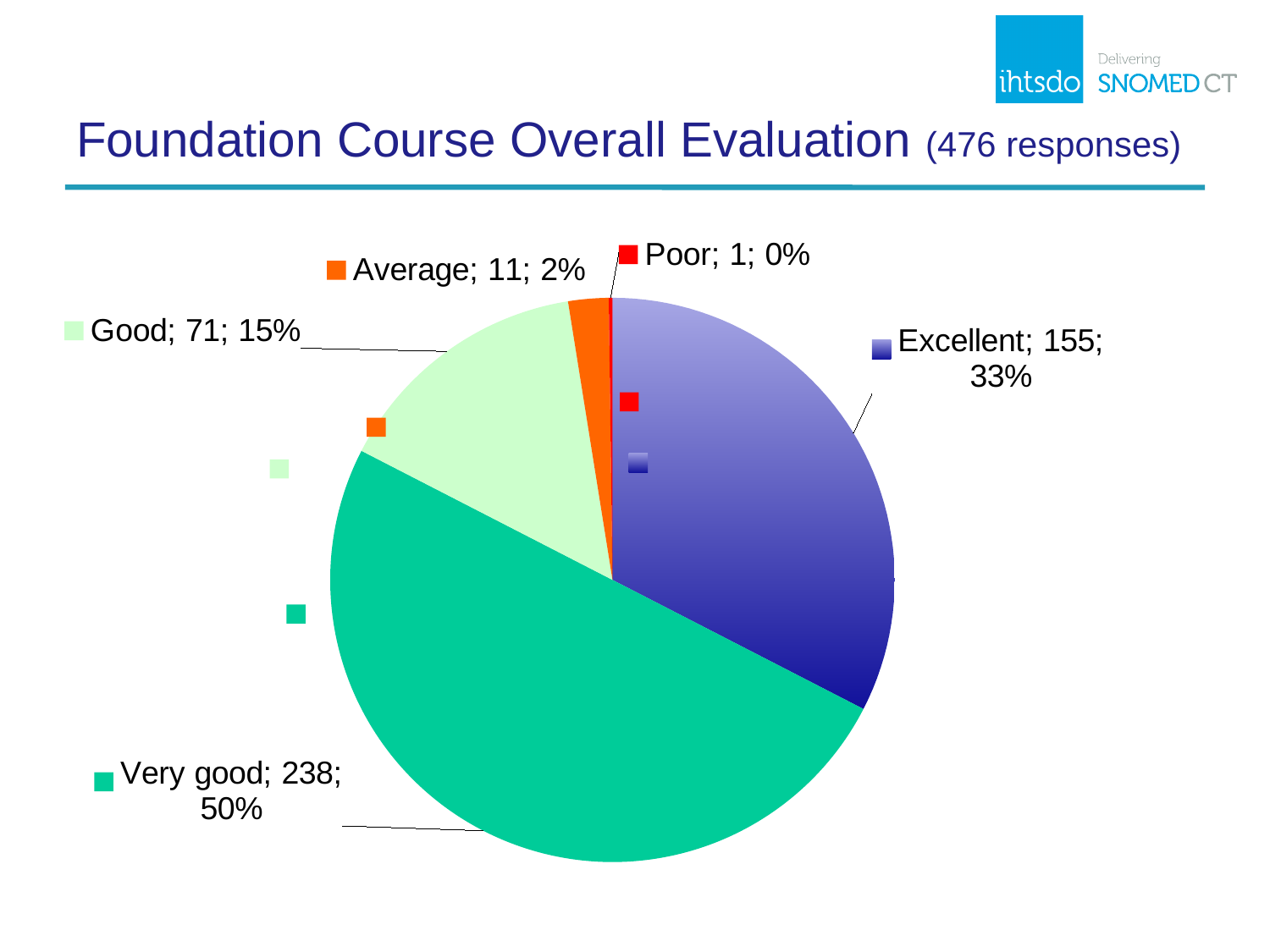
What is the difference between the number of Very good and Excellent responses? 83 What kind of chart is shown on the slide? pie chart How many responses were rated Good? 71 How many responses were rated Excellent? 155 Which rating category has the smallest slice of the pie? Poor What percentage of responses were rated Very good? 50% What percentage of responses were rated Average? 2% What is the title of the chart? Foundation Course Overall Evaluation (476 responses) How many rating categories are shown in the pie chart? 5 Which rating category has the largest slice of the pie? Very good Which has more responses, Good or Average? Good How many responses were rated Poor? 1